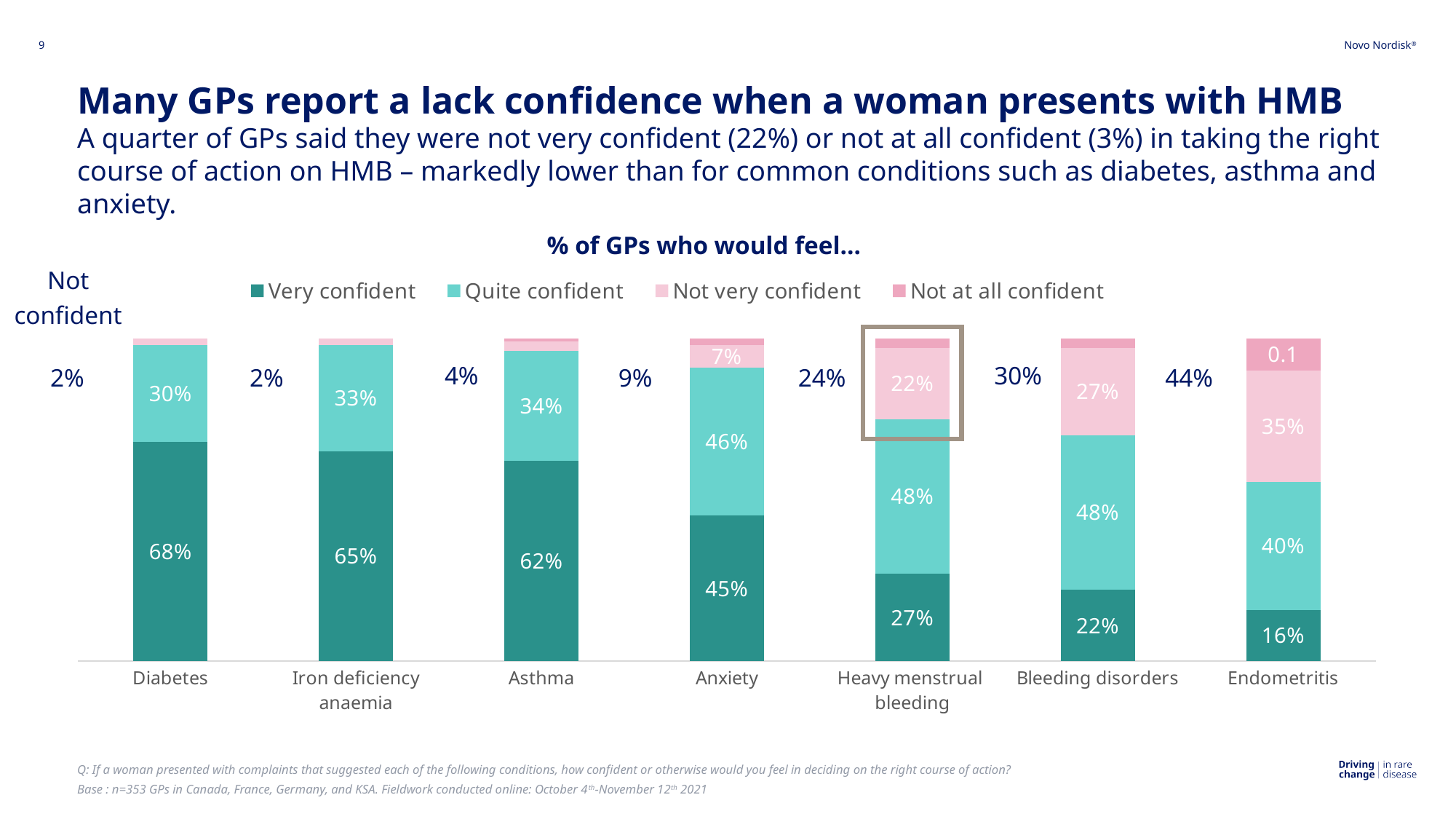
Which condition has the highest share of GPs who would feel very confident? Diabetes Which is larger: the quite confident percentage for Asthma or for Bleeding disorders? Bleeding disorders What is the difference between the very confident percentages for Diabetes and Heavy menstrual bleeding? 41% What kind of chart is shown on the slide? Stacked bar chart What percentage of GPs would feel very confident about Endometritis? 16% Which condition has the lowest share of GPs who would feel very confident? Endometritis How many conditions are shown on the x axis of the chart? 7 What is the 'Not confident' percentage annotated for Bleeding disorders? 30% What percentage of GPs would feel quite confident about Anxiety? 46% What percentage of GPs would feel very confident about Diabetes? 68% How many series does the chart legend list? 4 What percentage of GPs would feel not very confident about Heavy menstrual bleeding? 22%